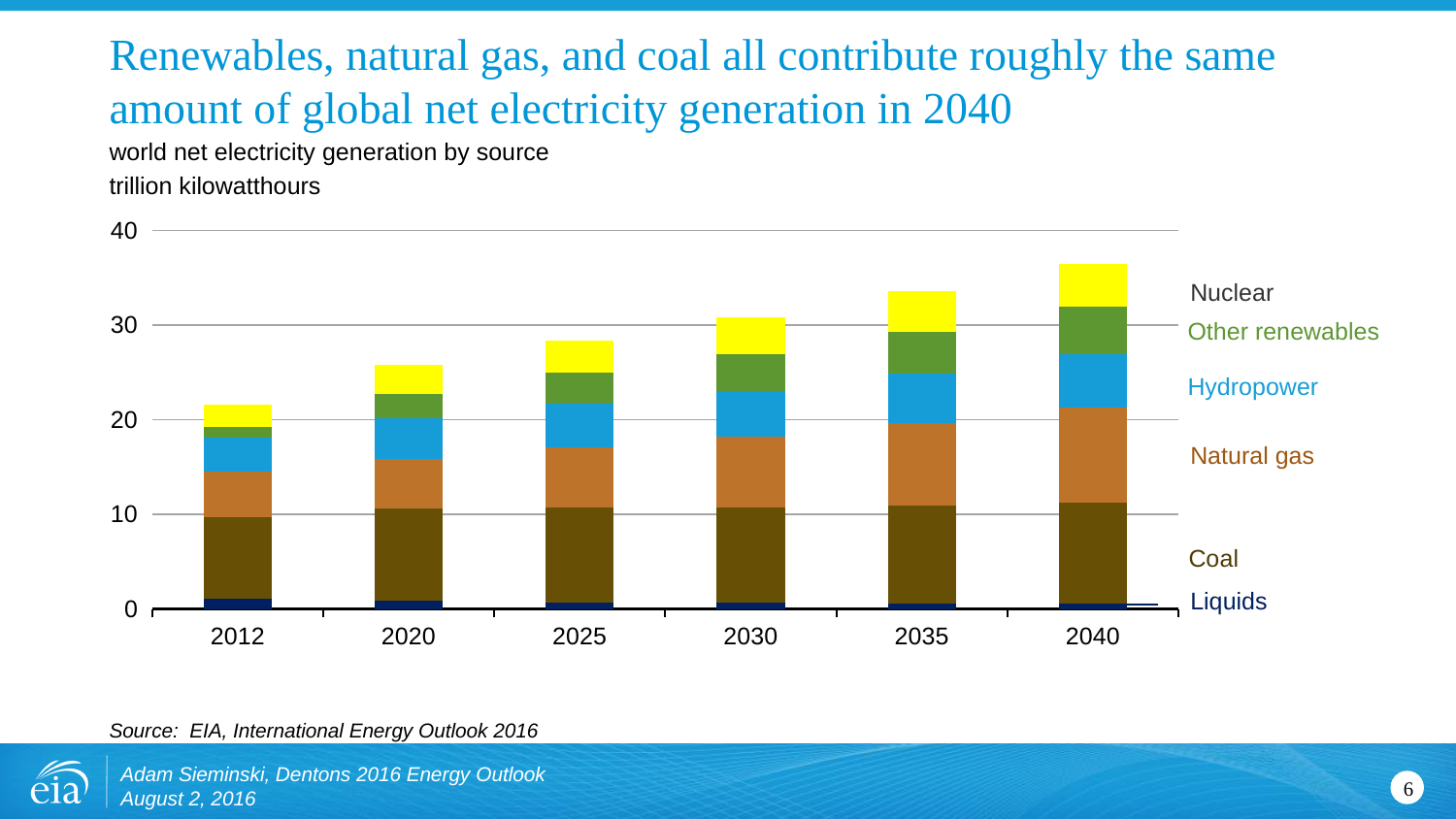
How many years are shown along the x axis of the chart? 6 Is the total value for 2035 greater or less than 40? less Is the total value for 2012 greater or less than 30? less Do the total bar heights rise or fall from 2012 to 2040? rise What kind of chart is shown on the slide? stacked bar chart Which year has the shortest stacked bar (lowest total net electricity generation)? 2012 Is the total value for 2020 greater or less than 20? greater Which source is listed at the top of the chart's legend? Nuclear Which year has the tallest stacked bar (highest total net electricity generation)? 2040 What unit is the chart's y axis measured in? trillion kilowatthours How many sources (series) does the chart's legend list? 6